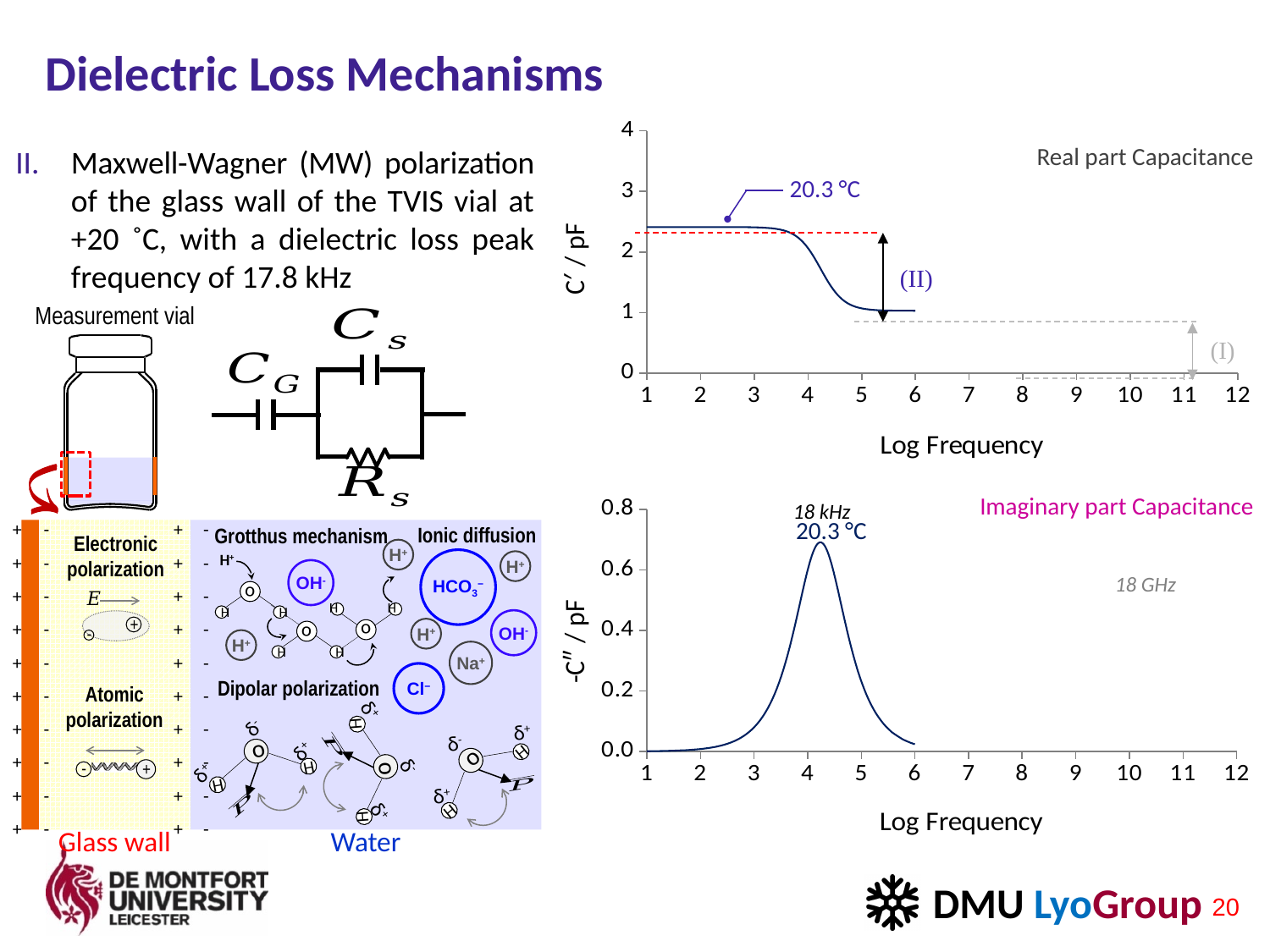
What kind of chart is the Imaginary part Capacitance chart? line chart In the Real part Capacitance chart, what is the x-axis label? Log Frequency In the Imaginary part Capacitance chart, what temperature is the curve labelled with? 20.3 °C In the Real part Capacitance chart, is the value of the curve at Log Frequency 2 greater or less than 2? greater In the Imaginary part Capacitance chart, what frequency is the peak labelled with? 18 kHz In the Imaginary part Capacitance chart, is the value of the curve at Log Frequency 2 greater or less than 0.2? less In the Real part Capacitance chart, does the curve rise or fall as Log Frequency increases from 3 to 5? fall In the Real part Capacitance chart, is the value of the curve at Log Frequency 6 greater or less than 2? less In the Imaginary part Capacitance chart, what is the y-axis label? -C″ / pF In the Imaginary part Capacitance chart, does the curve rise or fall as Log Frequency increases from 4.5 to 6? fall What kind of chart is the Real part Capacitance chart? line chart